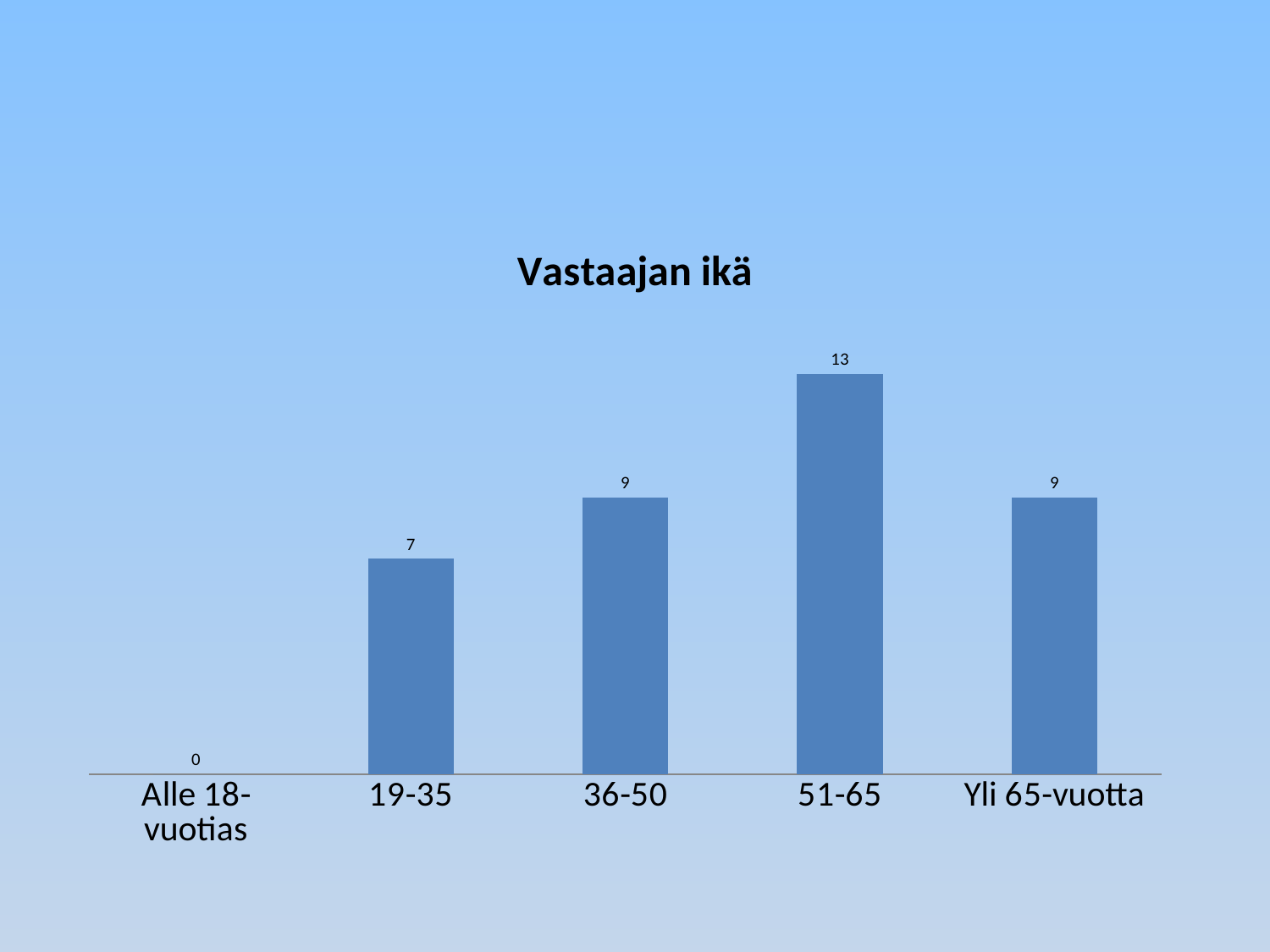
What is the value for the 19-35 category? 7 What is the title of the chart? Vastaajan ikä Which category has the lowest value? Alle 18-vuotias How many categories are shown on the x axis? 5 What is the value for the Alle 18-vuotias category? 0 What is the difference between the values for 51-65 and 36-50? 4 What is the total of all the values shown in the chart? 38 What kind of chart is shown on the slide? Bar chart What is the value for the 51-65 category? 13 Which is larger, the value for 19-35 or the value for 36-50? 36-50 What is the value for the Yli 65-vuotta category? 9 Which category has the highest value? 51-65